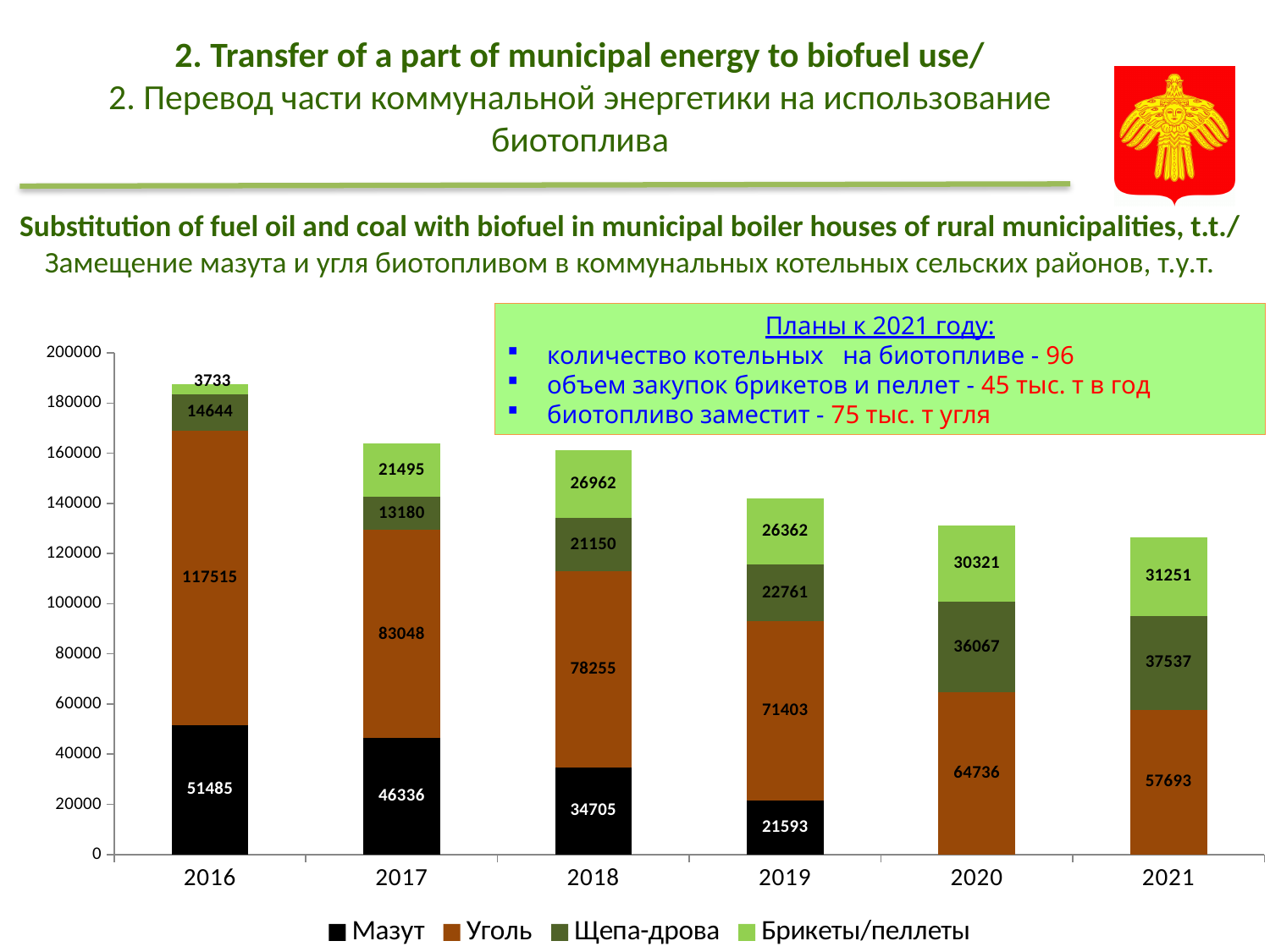
What kind of chart is shown on the slide? Stacked bar chart What is the difference between the Мазут values for 2016 and 2019? 29892 How many years are shown on the x axis? 6 Does the Мазут value rise or fall from 2016 to 2019? Fall In which year is the Брикеты/пеллеты value lowest? 2016 What is the value for Уголь in 2016? 117515 Which is larger in 2020: Щепа-дрова or Брикеты/пеллеты? Щепа-дрова What is the value for Брикеты/пеллеты in 2021? 31251 How many series does the legend list? 4 What is the value for Щепа-дрова in 2019? 22761 In which year is the Уголь value highest? 2016 What is the total of the stacked bar for 2021? 126481